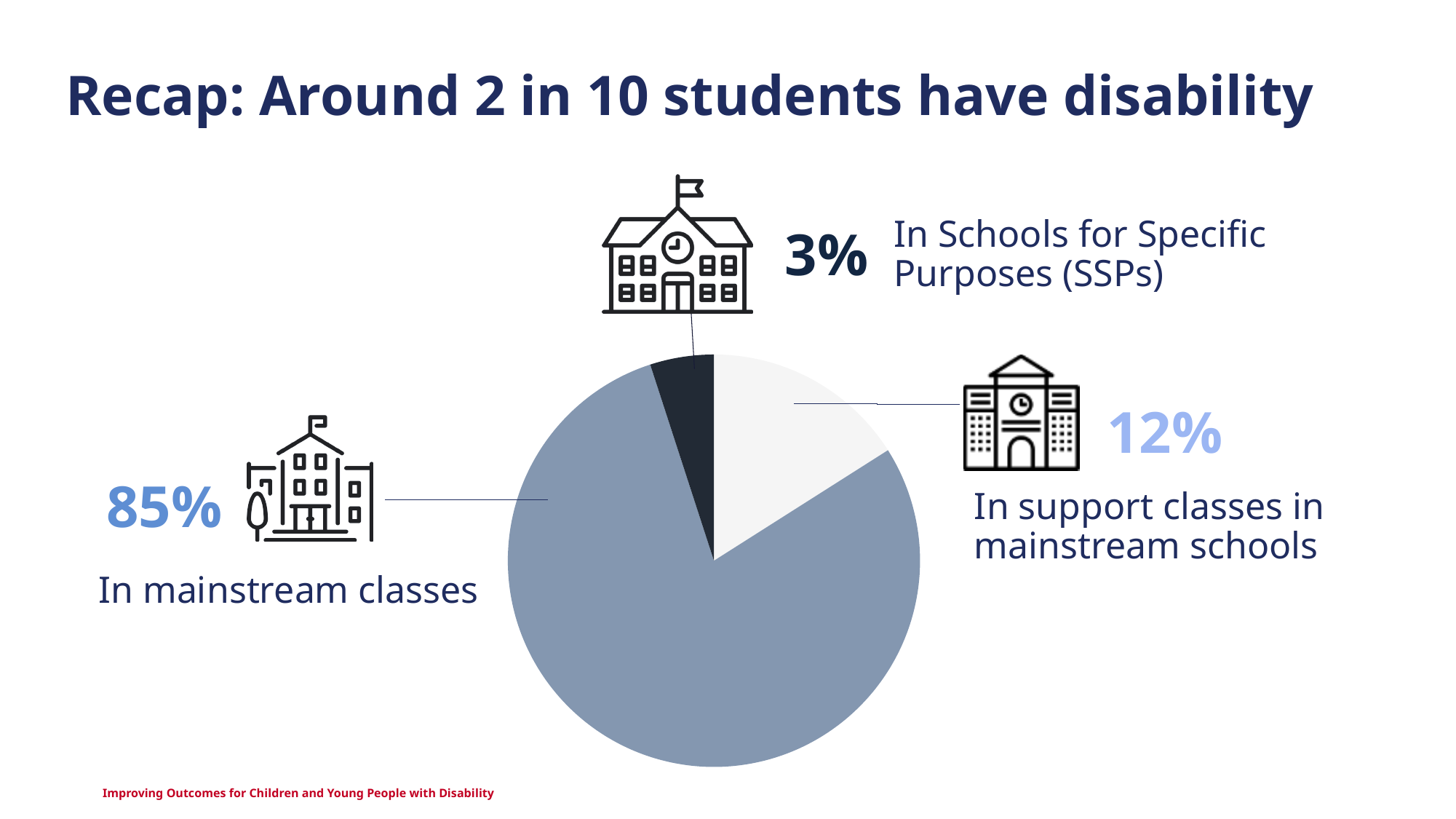
What is the difference in percentage points between students in support classes in mainstream schools and students in SSPs? 9 What colour is the slice representing students in mainstream classes? Grey-blue Which category has the largest share of the pie? In mainstream classes What percentage of students with disability are in mainstream classes? 85% Which is larger: the share in support classes in mainstream schools or the share in Schools for Specific Purposes? In support classes in mainstream schools What percentage of students with disability are in Schools for Specific Purposes (SSPs)? 3% What percentage of students with disability are in support classes in mainstream schools? 12% What kind of chart is shown on the slide? Pie chart What is the difference in percentage points between students in mainstream classes and students in support classes in mainstream schools? 73 How many slices does the pie chart have? 3 What is the title of the slide containing the pie chart? Recap: Around 2 in 10 students have disability Which category has the smallest share of the pie? In Schools for Specific Purposes (SSPs)